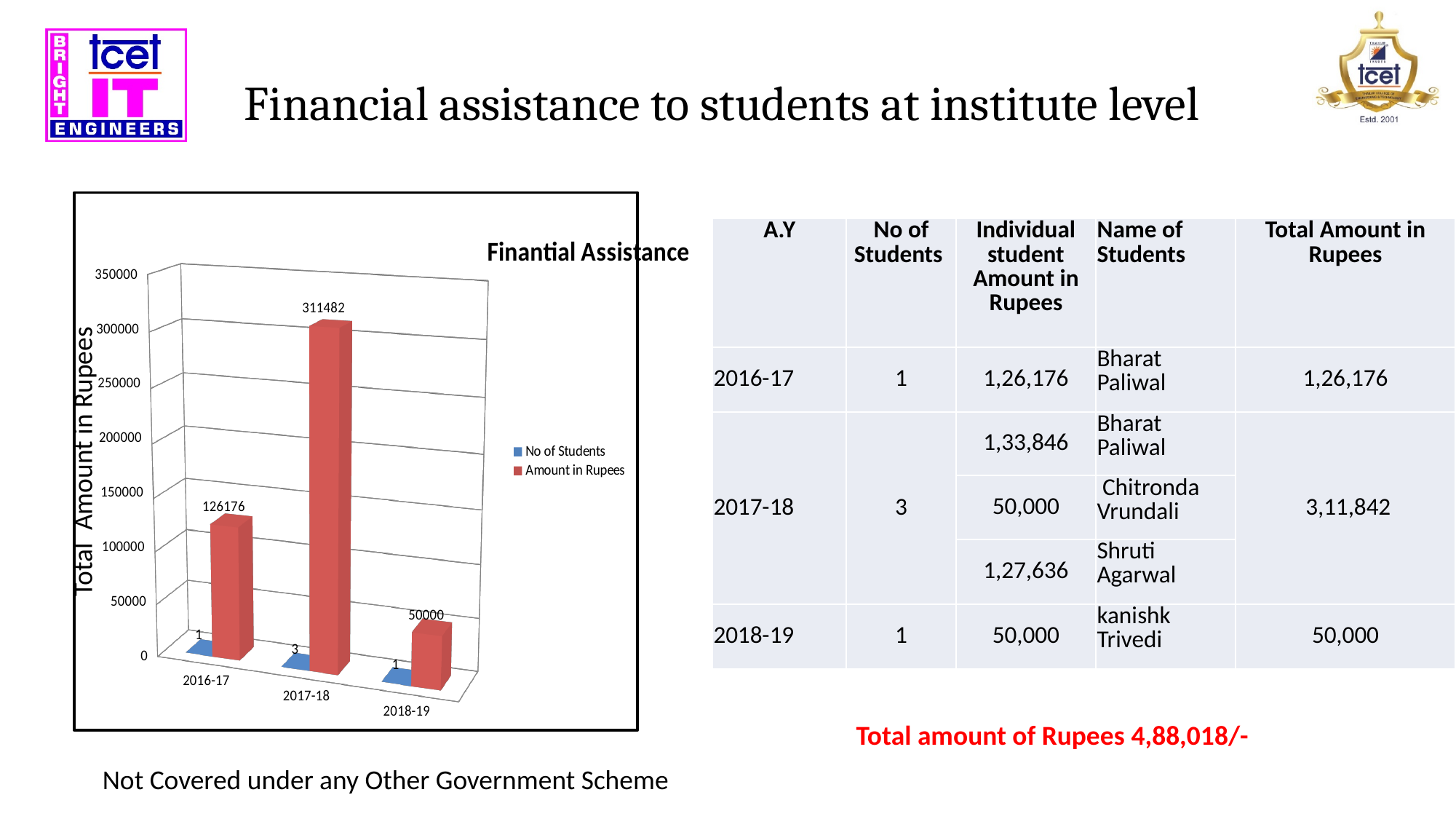
What kind of chart is shown on the slide? bar chart How many series does the chart legend list? 2 What is the Amount in Rupees for 2017-18 in the chart? 311482 What is the title of the chart on the slide? Finantial Assistance Which academic year has the lowest Amount in Rupees in the chart? 2018-19 What is the Amount in Rupees for 2018-19 in the chart? 50000 Which academic year has the highest Amount in Rupees in the chart? 2017-18 Is the Amount in Rupees for 2016-17 larger or smaller than that for 2018-19? larger What is the difference between the Amount in Rupees for 2017-18 and 2016-17 in the chart? 185306 What is the Amount in Rupees for 2016-17 in the chart? 126176 How many academic years are shown on the x axis of the chart? 3 What is the No of Students value for 2017-18 in the chart? 3